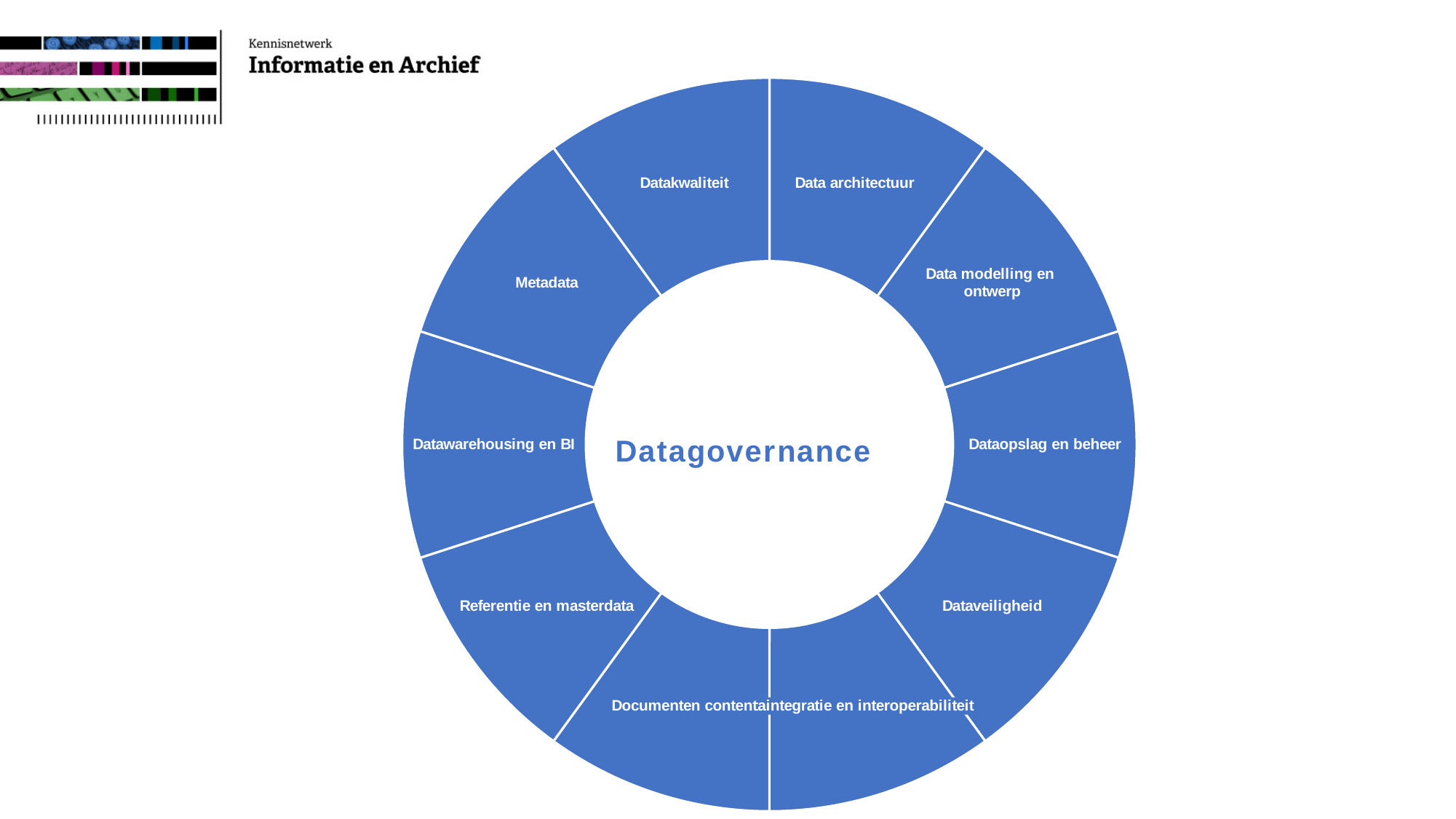
Are the segments of the doughnut chart shown in different colours or all in the same colour? All in the same colour What kind of chart is shown on the slide? Doughnut chart What text is shown in the centre of the doughnut chart? Datagovernance Which segment is labelled between 'Metadata' and 'Data architectuur' going clockwise? Datakwaliteit Which segment is labelled between 'Dataopslag en beheer' and the bottom segments going clockwise? Dataveiligheid Which segment label appears directly to the left of the centre of the chart? Datawarehousing en BI How many segments does the doughnut chart have? 10 Which segment is labelled between 'Datawarehousing en BI' and the bottom segments going counter-clockwise? Referentie en masterdata Which segment is labelled between 'Data architectuur' and 'Dataopslag en beheer' going clockwise? Data modelling en ontwerp Which segment label appears directly to the right of the centre of the chart? Dataopslag en beheer